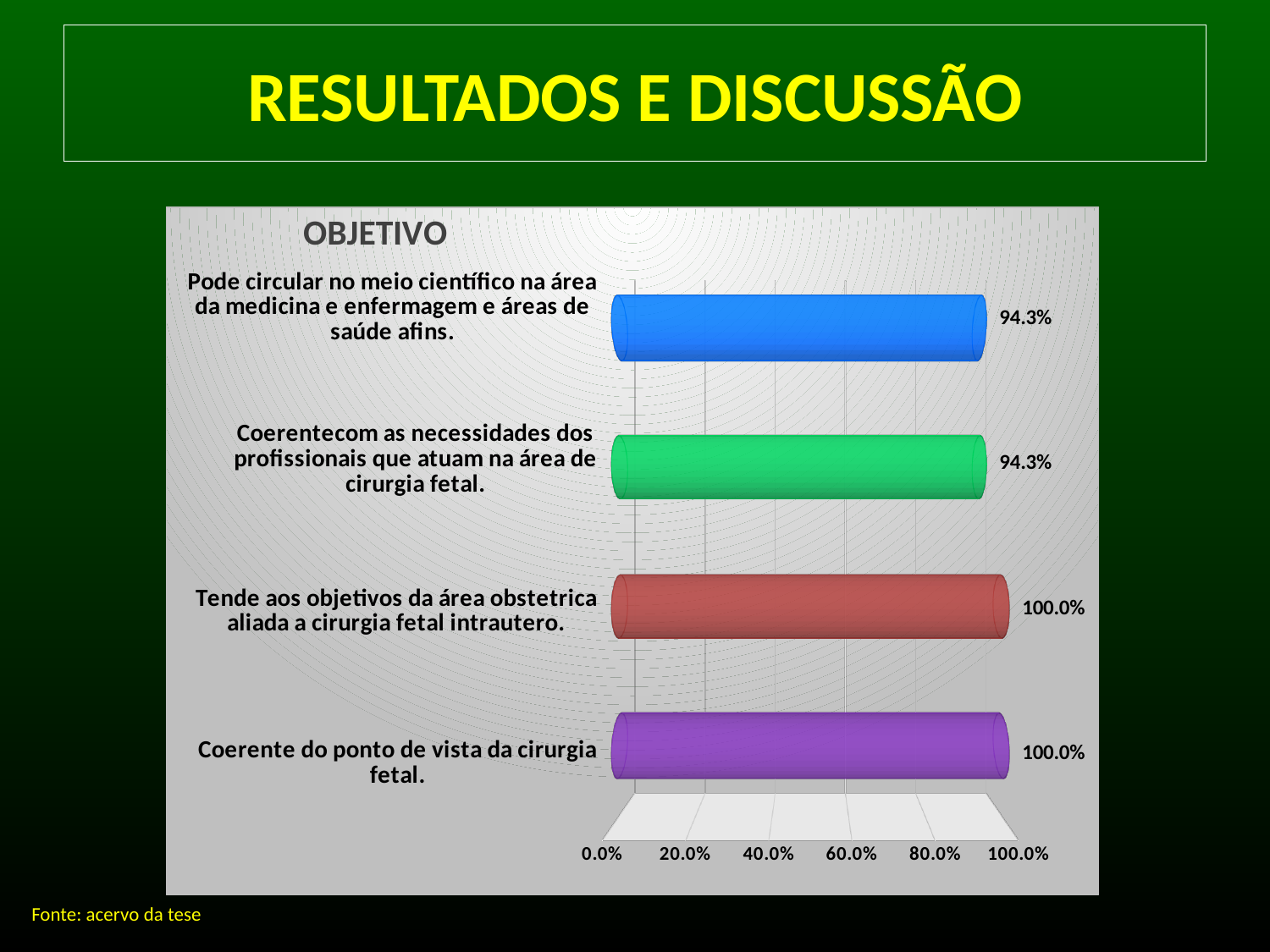
What is the value for "Coerente do ponto de vista da cirurgia fetal."? 100.0% Is the value for "Pode circular no meio científico na área da medicina e enfermagem e áreas de saúde afins." greater or less than 80.0%? greater What is the value for "Coerentecom as necessidades dos profissionais que atuam na área de cirurgia fetal."? 94.3% What is the difference between the value for "Coerente do ponto de vista da cirurgia fetal." and the value for "Coerentecom as necessidades dos profissionais que atuam na área de cirurgia fetal."? 5.7% What is the value for "Tende aos objetivos da área obstetrica aliada a cirurgia fetal intrautero."? 100.0% What kind of chart is shown on the slide? bar chart What colour is the bar for "Coerente do ponto de vista da cirurgia fetal."? purple How many categories have a value of 100.0%? 2 What is the value for "Pode circular no meio científico na área da medicina e enfermagem e áreas de saúde afins."? 94.3% Which is larger: the value for "Tende aos objetivos da área obstetrica aliada a cirurgia fetal intrautero." or the value for "Pode circular no meio científico na área da medicina e enfermagem e áreas de saúde afins."? Tende aos objetivos da área obstetrica aliada a cirurgia fetal intrautero. How many categories are shown in the chart? 4 What is the title of the chart? OBJETIVO